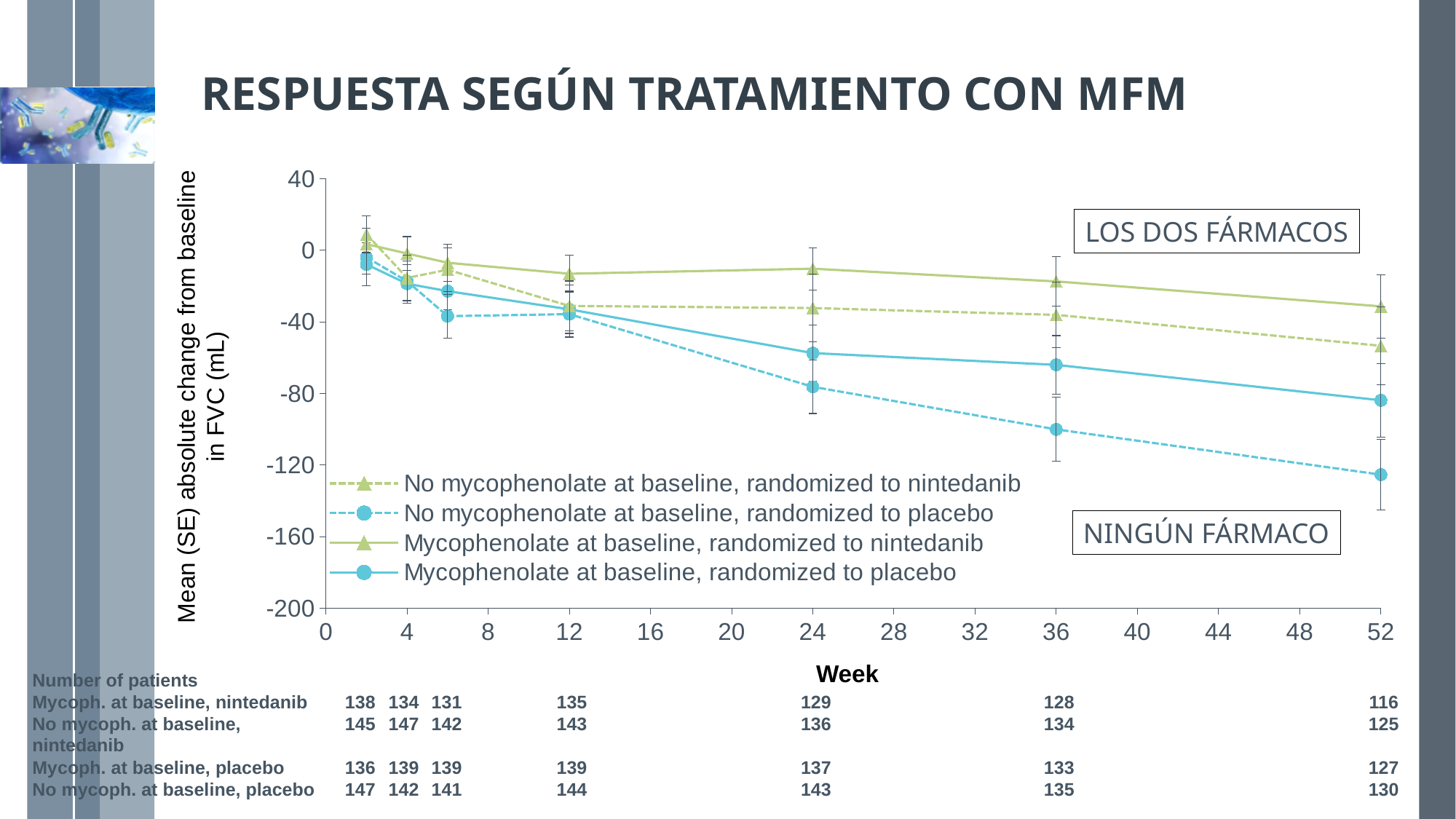
How many time points are plotted for each series? 7 What is the label of the x axis? Week How many series does the legend list? 4 Do the values for 'No mycophenolate at baseline, randomized to placebo' rise or fall as the weeks increase? fall Which series has the highest value at week 52? Mycophenolate at baseline, randomized to nintedanib Is the value for 'No mycophenolate at baseline, randomized to placebo' at week 52 greater or less than -80? less Which series has the lowest value at week 52? No mycophenolate at baseline, randomized to placebo Is the value for 'No mycophenolate at baseline, randomized to nintedanib' at week 52 greater or less than -40? less At week 52, which is higher: 'Mycophenolate at baseline, randomized to placebo' or 'No mycophenolate at baseline, randomized to placebo'? Mycophenolate at baseline, randomized to placebo Is the value for 'Mycophenolate at baseline, randomized to nintedanib' at week 52 greater or less than -40? greater What kind of chart is shown on the slide? line chart What is the label of the y axis? Mean (SE) absolute change from baseline in FVC (mL)